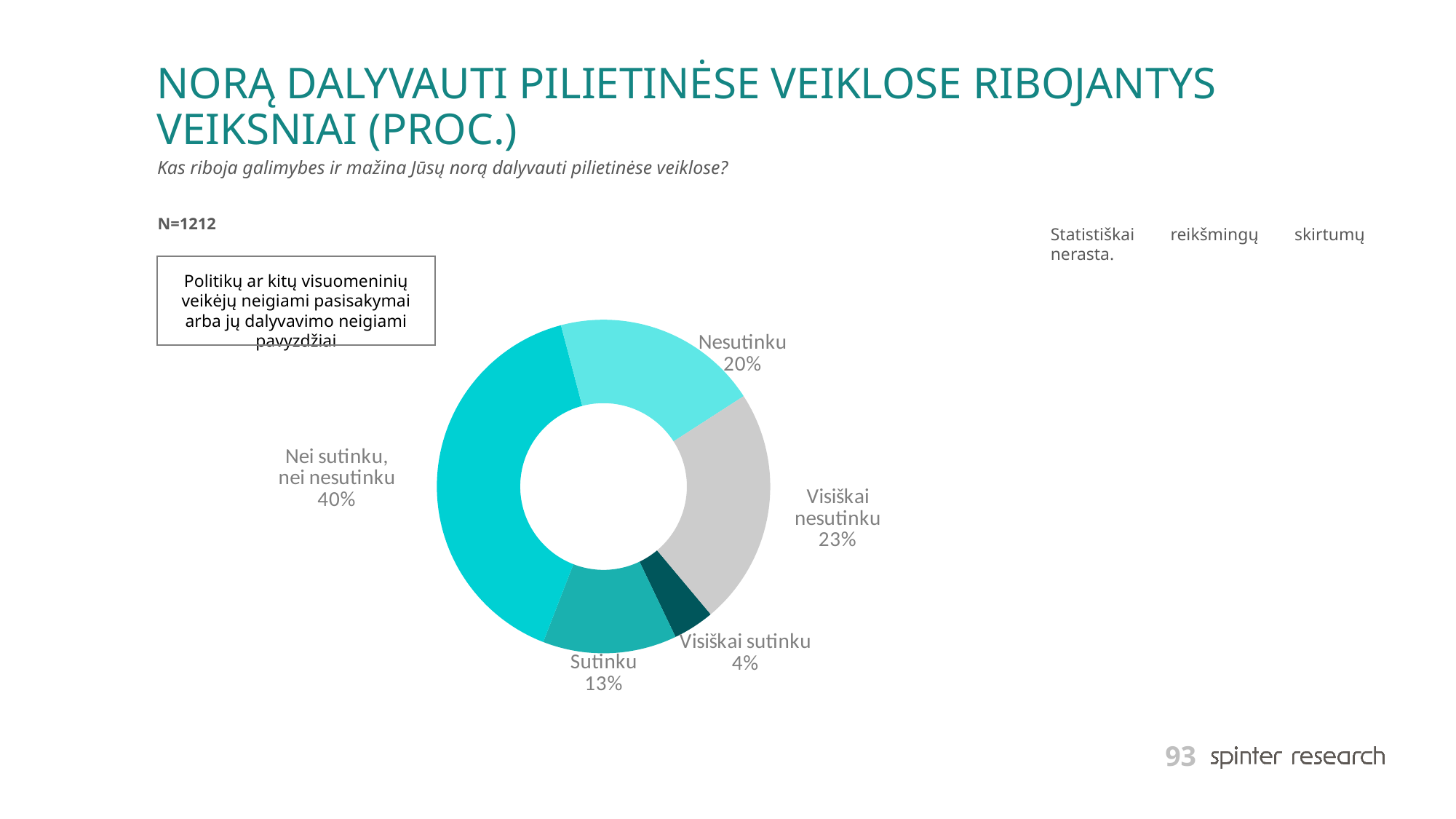
Which response category has the largest share? Nei sutinku, nei nesutinku Which response category has the smallest share? Visiškai sutinku What share of respondents answered "Sutinku"? 13% What is the difference in percentage points between "Visiškai nesutinku" and "Nesutinku"? 3 What is the sample size (N) stated on the slide? N=1212 Which is larger, the share for "Sutinku" or the share for "Nesutinku"? Nesutinku What share of respondents answered "Visiškai sutinku"? 4% What is the combined share of "Sutinku" and "Visiškai sutinku"? 17% What share of respondents answered "Nei sutinku, nei nesutinku"? 40% How many response categories are shown in the chart? 5 What kind of chart is shown on the slide? Doughnut (pie) chart What share of respondents answered "Visiškai nesutinku"? 23%